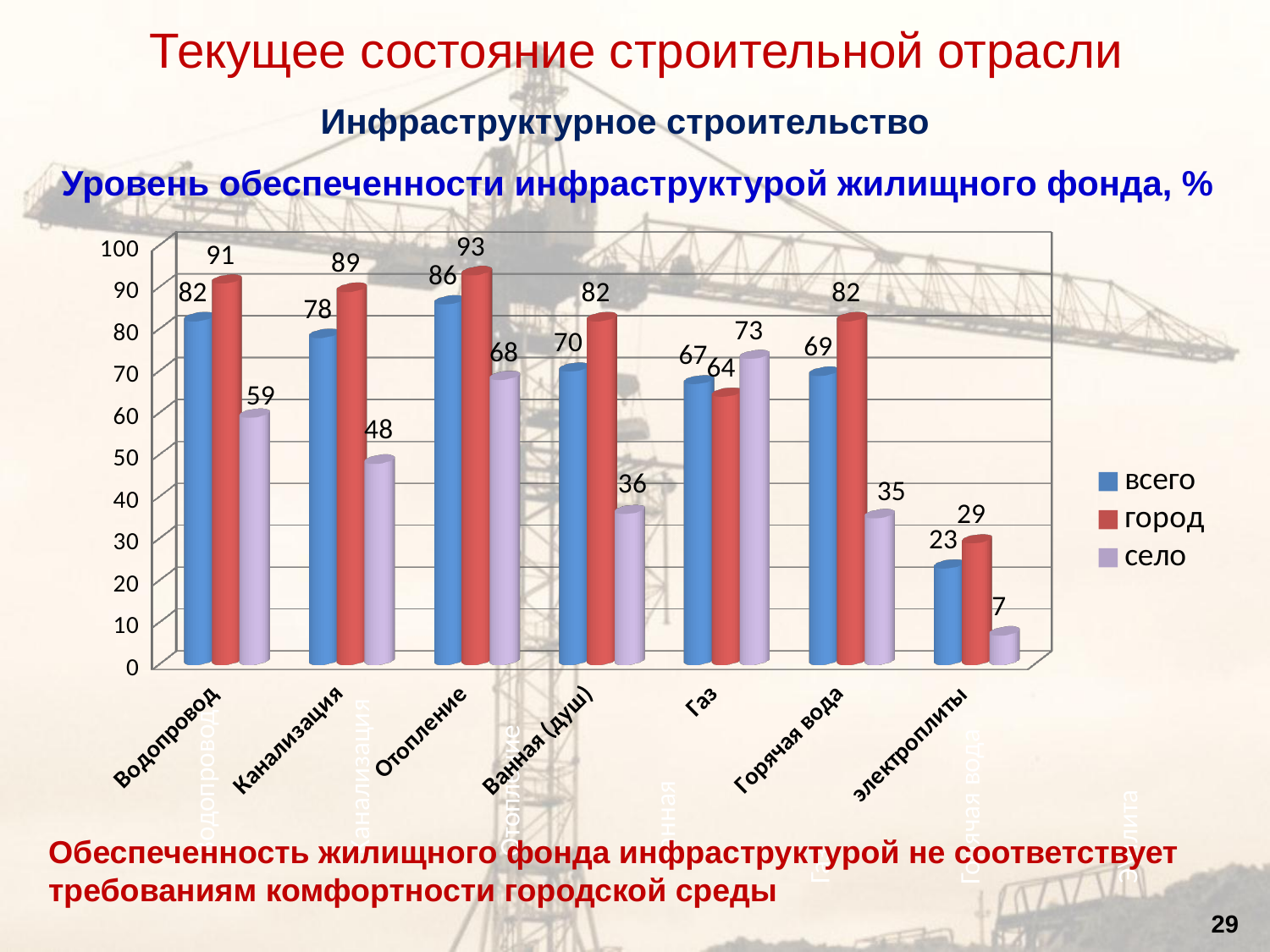
How many categories are shown on the x axis of the chart? 7 How many series does the chart legend list? 3 What is the difference between the "город" and "село" values in the "Ванная (душ)" category? 46 Which category has the lowest value for the "село" series? электроплиты What is the value for "всего" in the "Отопление" category? 86 What kind of chart is shown on the slide? bar chart Which series is shown in red in the chart legend? город In the "Газ" category, which is larger: the value for "город" or the value for "село"? село Which category has the highest value for the "город" series? Отопление What is the value for "город" in the "Водопровод" category? 91 What is the value for "село" in the "Горячая вода" category? 35 What is the value for "село" in the "Канализация" category? 48